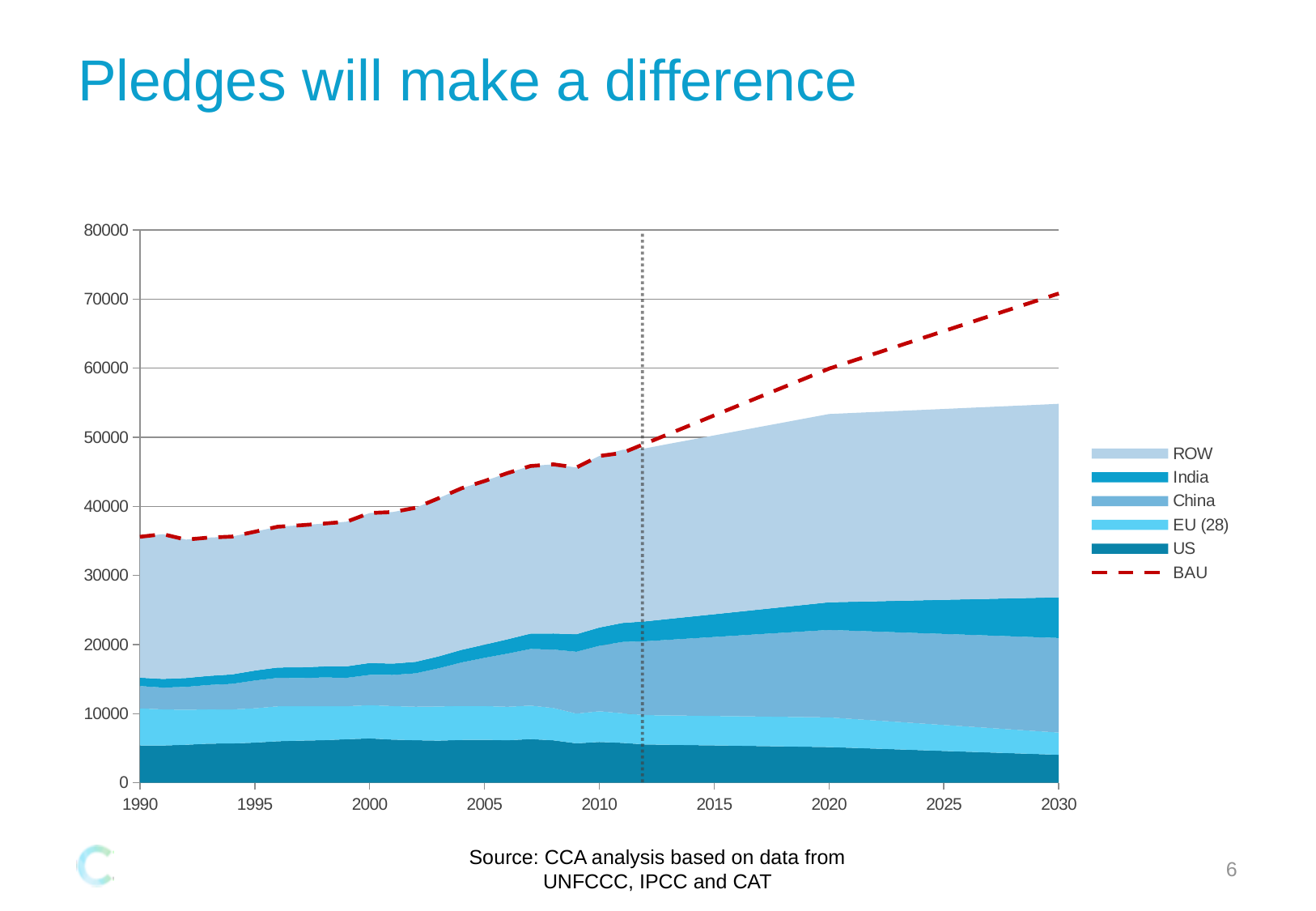
Is the BAU value in 2030 greater or less than 60000? greater Does the BAU line rise or fall from 1990 to 2030? Rises What is the title of the slide? Pledges will make a difference Which series is drawn as a red dashed line? BAU Is the total of the stacked areas in 2030 greater or less than 60000? less What kind of chart is shown on the slide? Stacked area chart with a dashed line How many series does the legend list? 6 Is the BAU value in 1990 greater or less than 30000? greater In 2030, which is higher: the BAU line or the top of the stacked areas? BAU Does the total of the stacked areas rise or fall from 1990 to 2030? Rises Which series forms the bottom layer of the stacked areas? US